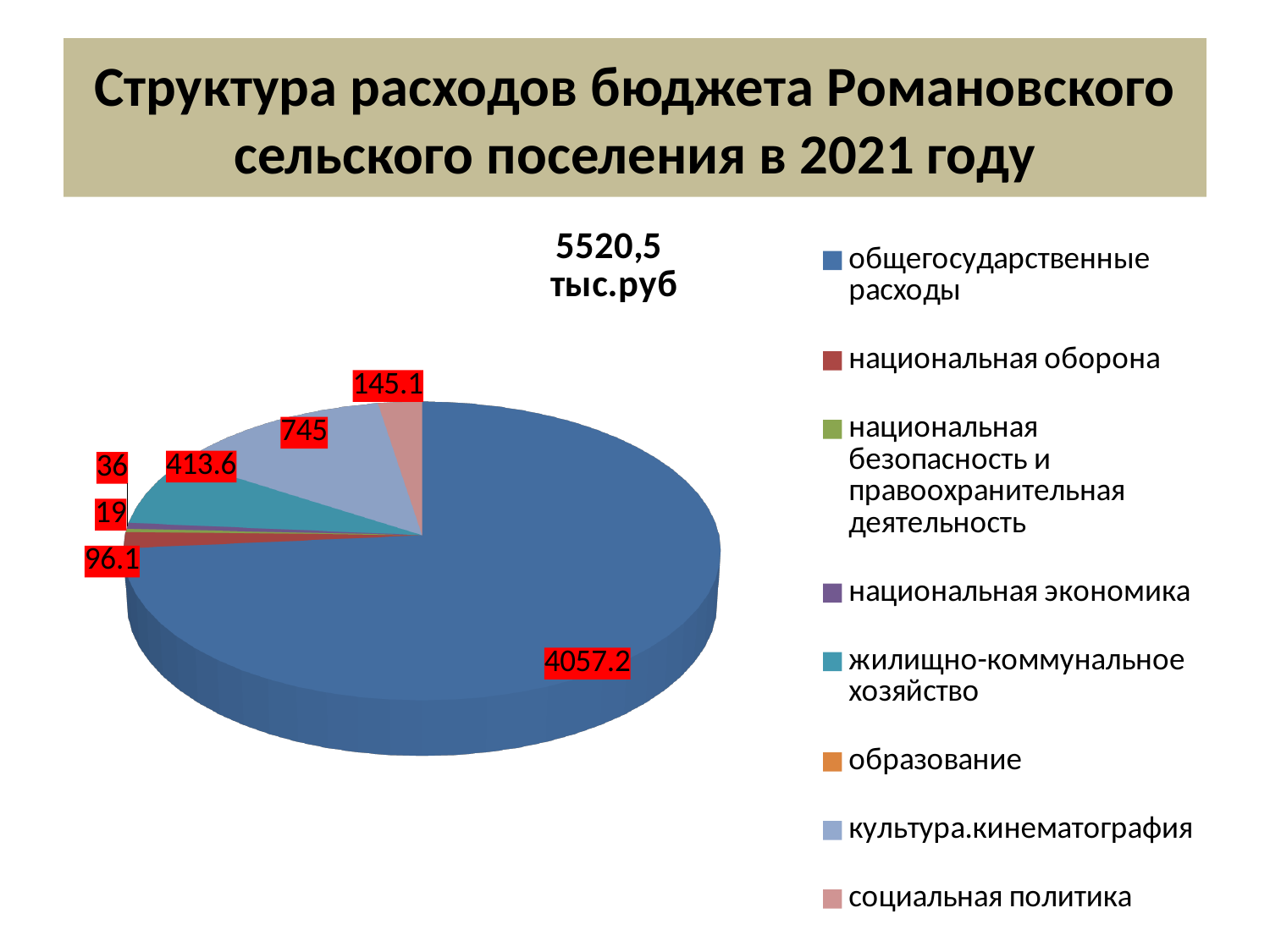
How many categories does the legend list? 8 What is the value for общегосударственные расходы? 4057.2 What is the value for жилищно-коммунальное хозяйство? 413.6 What is the value for социальная политика? 145.1 What total amount is shown in the chart title? 5520,5 тыс.руб What is the value for национальная оборона? 96.1 Which is larger, культура.кинематография or жилищно-коммунальное хозяйство? культура.кинематография What kind of chart is shown on the slide? pie chart What is the value for культура.кинематография? 745 What is the difference between the values for социальная политика and национальная оборона? 49 Which category has the largest slice of the pie? общегосударственные расходы What is the difference between the values for культура.кинематография and жилищно-коммунальное хозяйство? 331.4